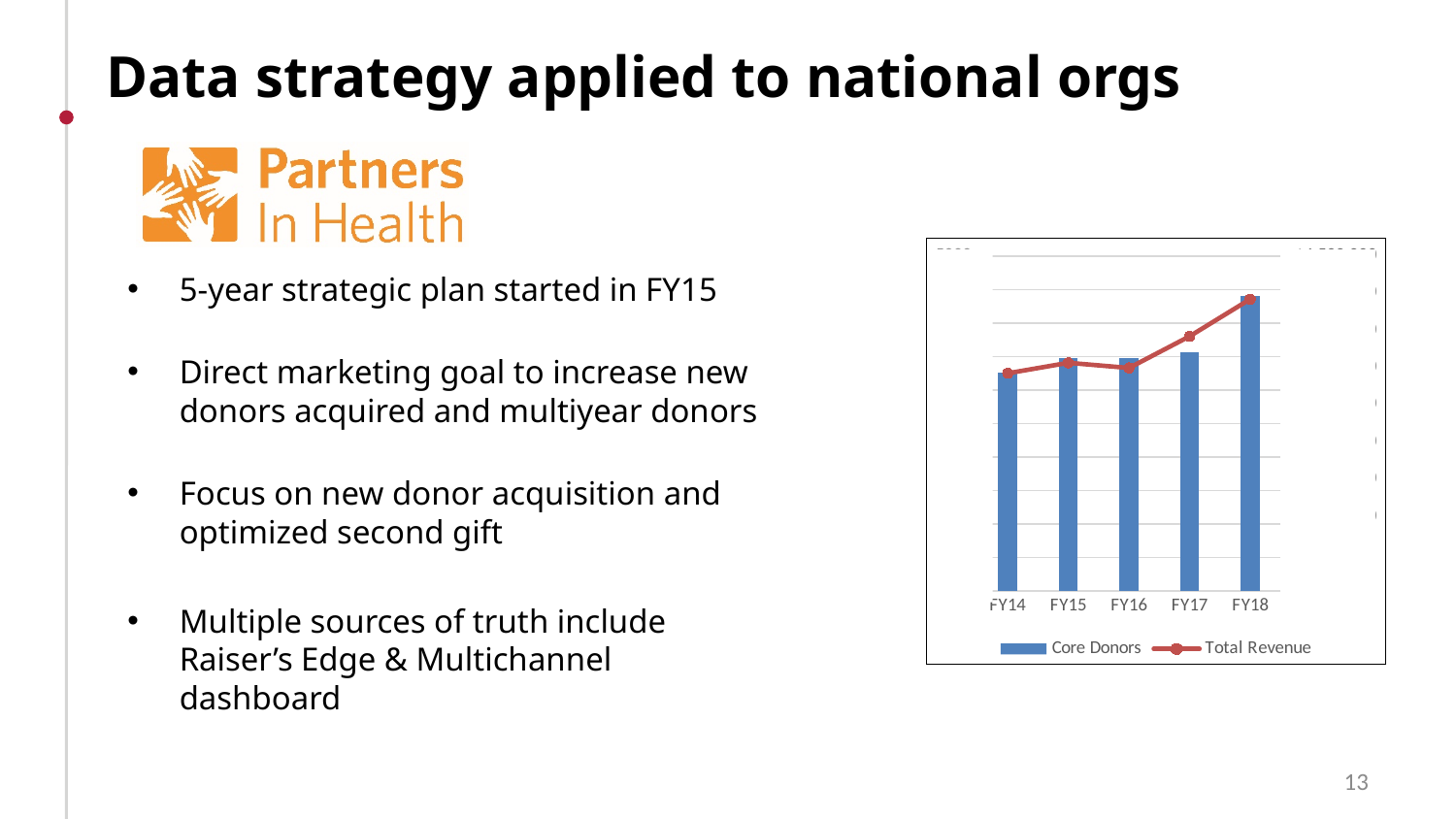
Which fiscal year has the highest Total Revenue point? FY18 Do the Core Donors bars generally rise or fall from FY14 to FY18? Rise How many series does the chart's legend list? 2 Which series in the chart is plotted as a line with markers? Total Revenue Is the Core Donors bar larger for FY18 or FY17? FY18 Does Total Revenue rise or fall from FY16 to FY18? Rise Which series in the chart is plotted as bars? Core Donors Which fiscal year has the highest Core Donors bar? FY18 What kind of chart is shown on the slide? A combined bar and line chart Is the Total Revenue value higher for FY18 or FY14? FY18 How many fiscal years are shown on the x axis of the chart? 5 Is the Core Donors bar larger for FY17 or FY15? FY17